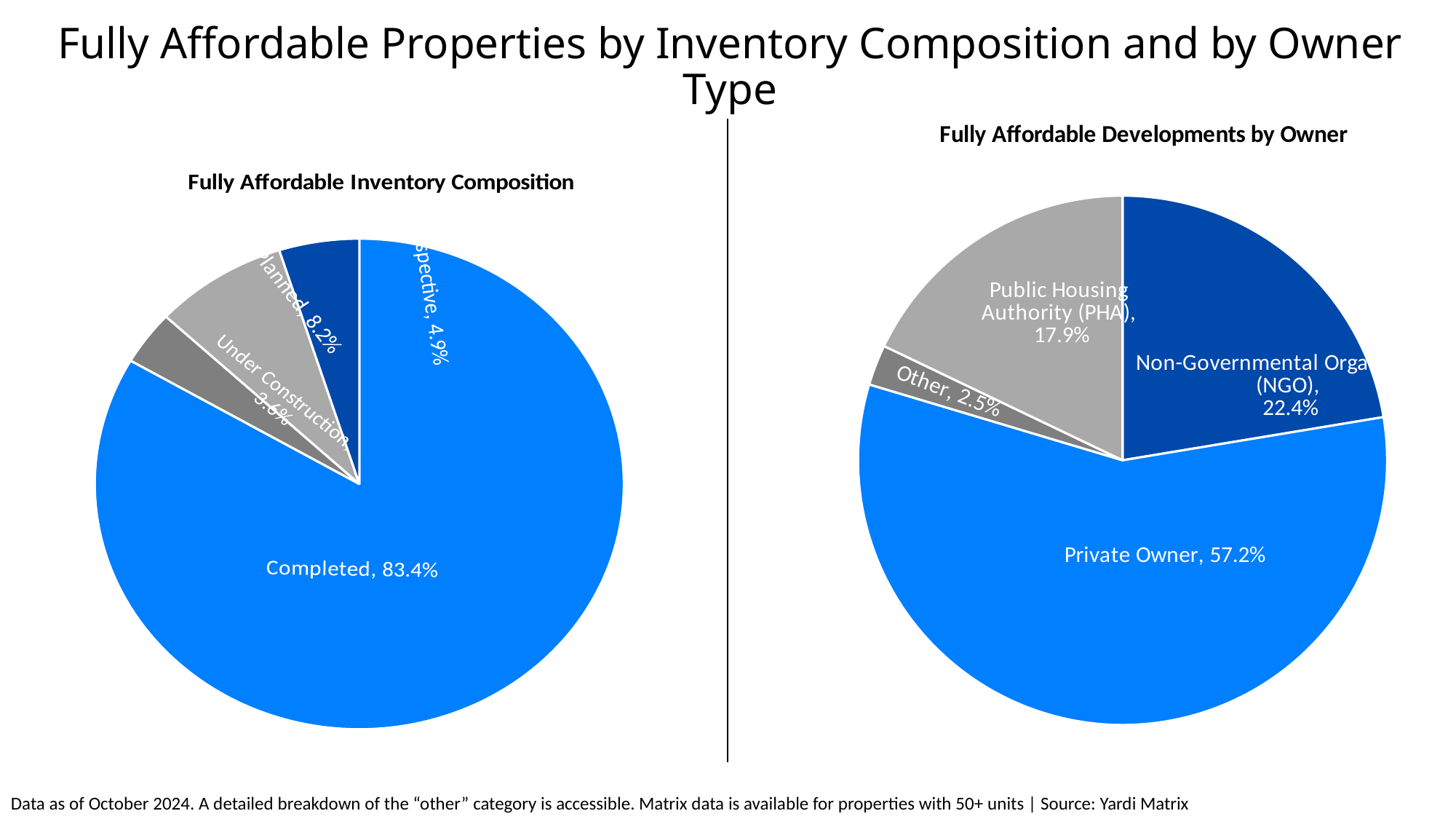
In the Fully Affordable Developments by Owner chart, what share is Private Owner? 57.2% In the Fully Affordable Inventory Composition chart, which category has the largest slice? Completed In the Fully Affordable Developments by Owner chart, which is larger: Non-Governmental Organization (NGO) or Public Housing Authority (PHA)? Non-Governmental Organization (NGO) How many slices does the Fully Affordable Inventory Composition pie chart have? 4 In the Fully Affordable Inventory Composition chart, what share is Under Construction? 3.6% In the Fully Affordable Inventory Composition chart, what share is Completed? 83.4% In the Fully Affordable Developments by Owner chart, what share is Public Housing Authority (PHA)? 17.9% What kind of chart is the Fully Affordable Inventory Composition chart? Pie chart How many slices does the Fully Affordable Developments by Owner pie chart have? 4 In the Fully Affordable Developments by Owner chart, what is the difference between the Private Owner share and the Non-Governmental Organization (NGO) share? 34.8% In the Fully Affordable Developments by Owner chart, which category has the smallest slice? Other In the Fully Affordable Developments by Owner chart, what share is Non-Governmental Organization (NGO)? 22.4%